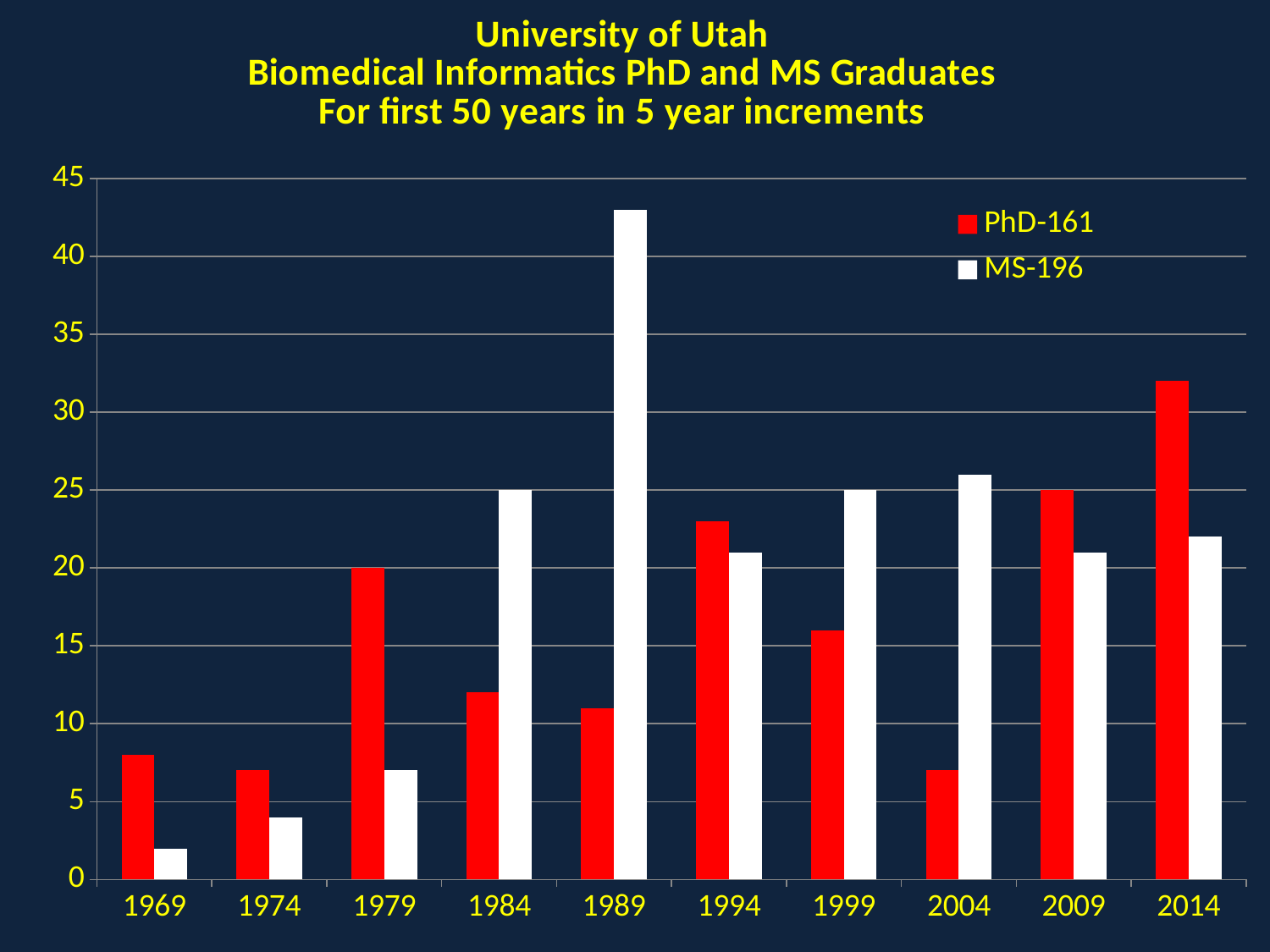
How many series does the legend list? 2 In which year is the MS bar lowest? 1969 What is the PhD value for 1979? 20 What is the MS value for 1984? 25 Is the MS value for 1989 greater or less than 40? greater How many year categories are shown on the x axis? 10 In 2014, which is larger, the PhD bar or the MS bar? PhD What is the PhD value for 2009? 25 In which year is the MS bar highest? 1989 What kind of chart is shown on the slide? bar chart In which year is the PhD bar highest? 2014 Which colour represents the PhD series in the legend? red